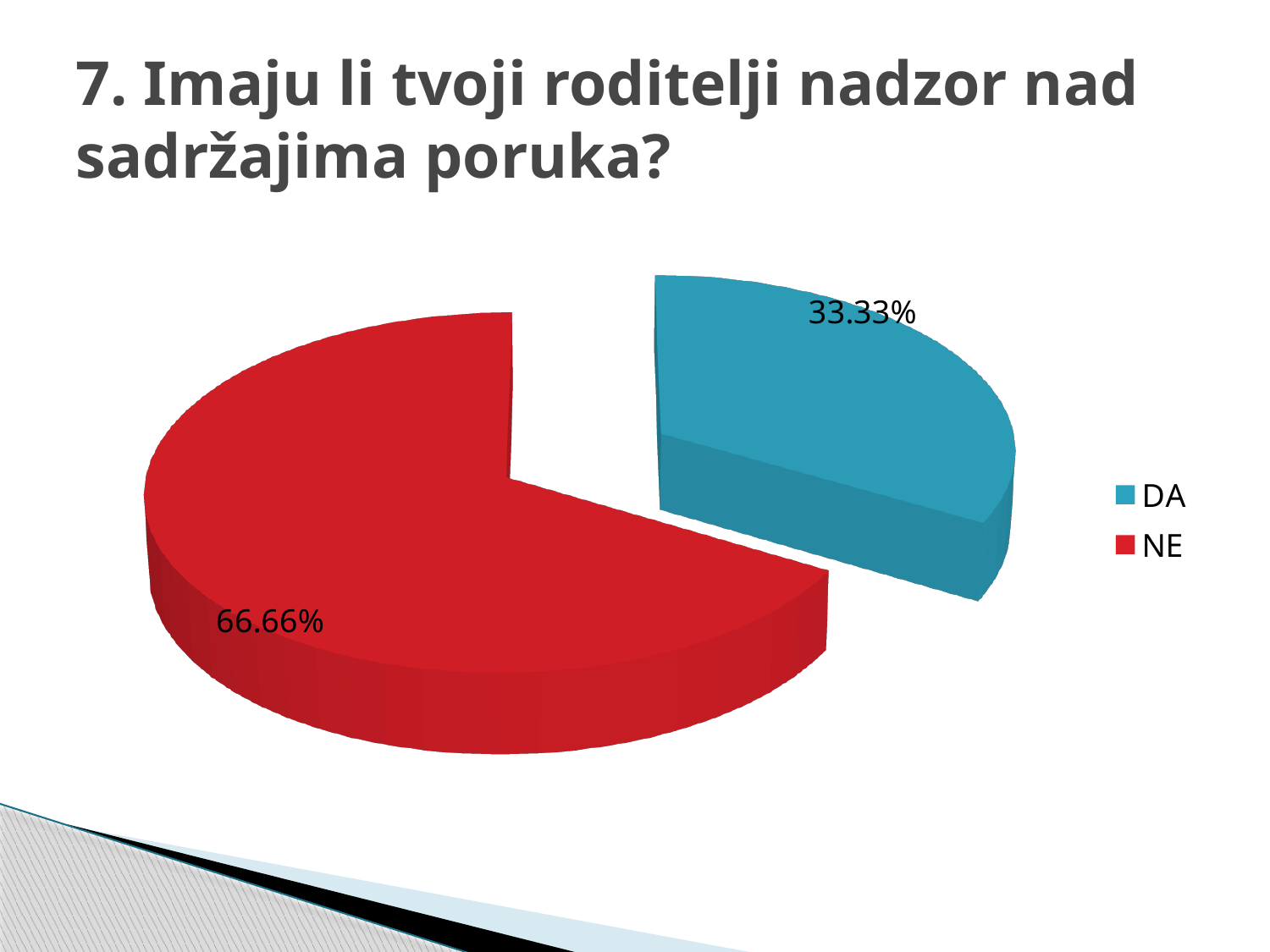
How many entries does the legend list? 2 Which category has the largest slice of the pie? NE What is the title of the slide above the chart? 7. Imaju li tvoji roditelji nadzor nad sadržajima poruka? What is the difference between the NE and DA percentages? 33.33% What colour is the DA slice? blue What share of the pie does the NE slice represent? 66.66% What kind of chart is shown on the slide? pie chart Which category has the smallest slice of the pie? DA What percentage is shown for the DA slice? 33.33% Which is larger, the DA slice or the NE slice? NE What percentage is shown for the NE slice? 66.66% How many slices does the pie chart have? 2